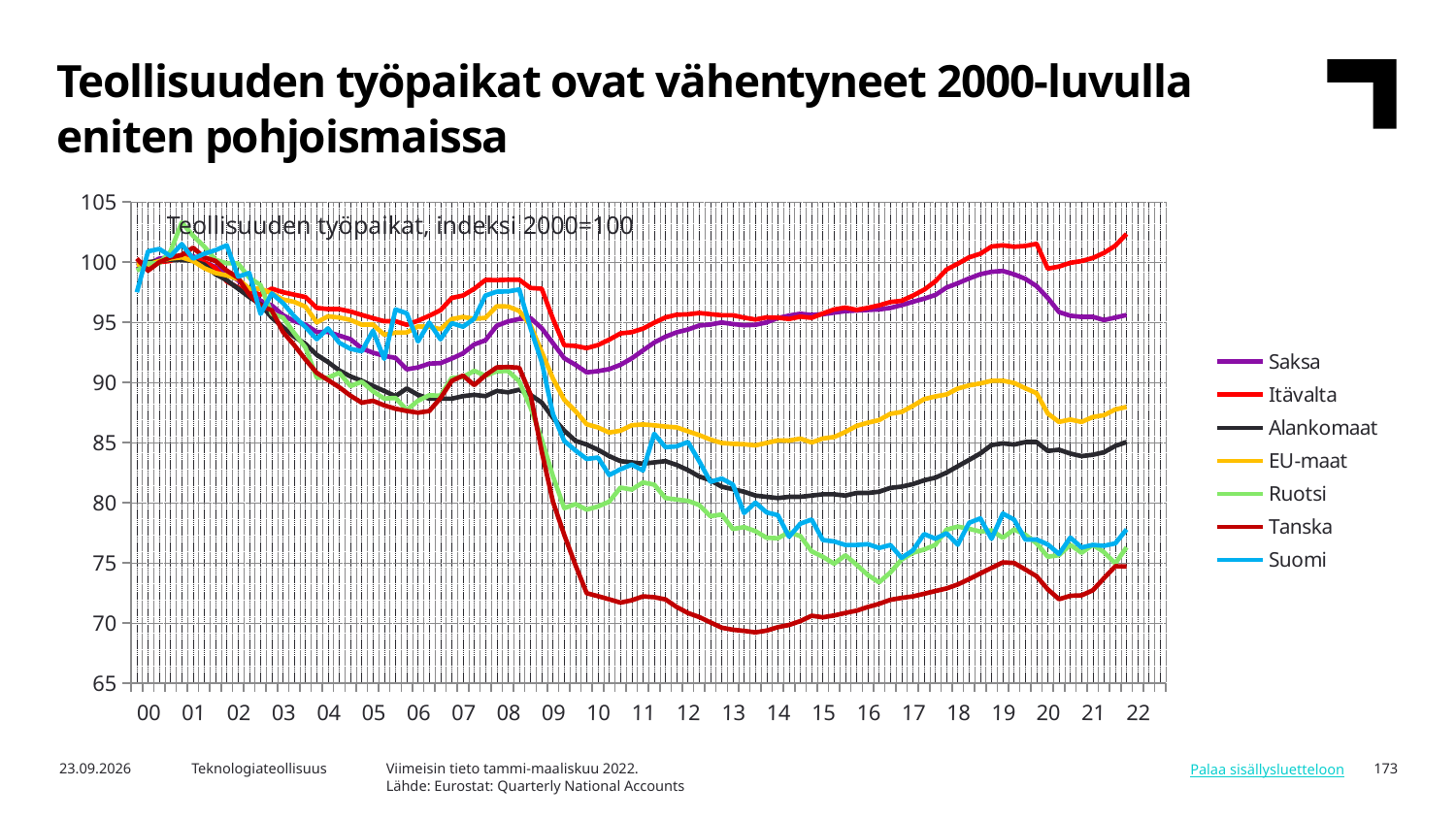
What kind of chart is shown on the slide? line chart Which series has the highest value in 2022? Itävalta Does the Tanska line rise or fall between 2008 and 2010? fall How many series does the legend list? 7 Is the value for Itävalta in 2022 greater or less than 100? greater Is the value for Tanska in 2014 greater or less than 75? less Which series has the lowest value in 2014? Tanska Is the value for Alankomaat in 2014 greater or less than 85? less What is the title printed inside the chart area? Teollisuuden työpaikat, indeksi 2000=100 Which series is drawn in red in the chart? Itävalta How many year labels are shown on the x axis? 23